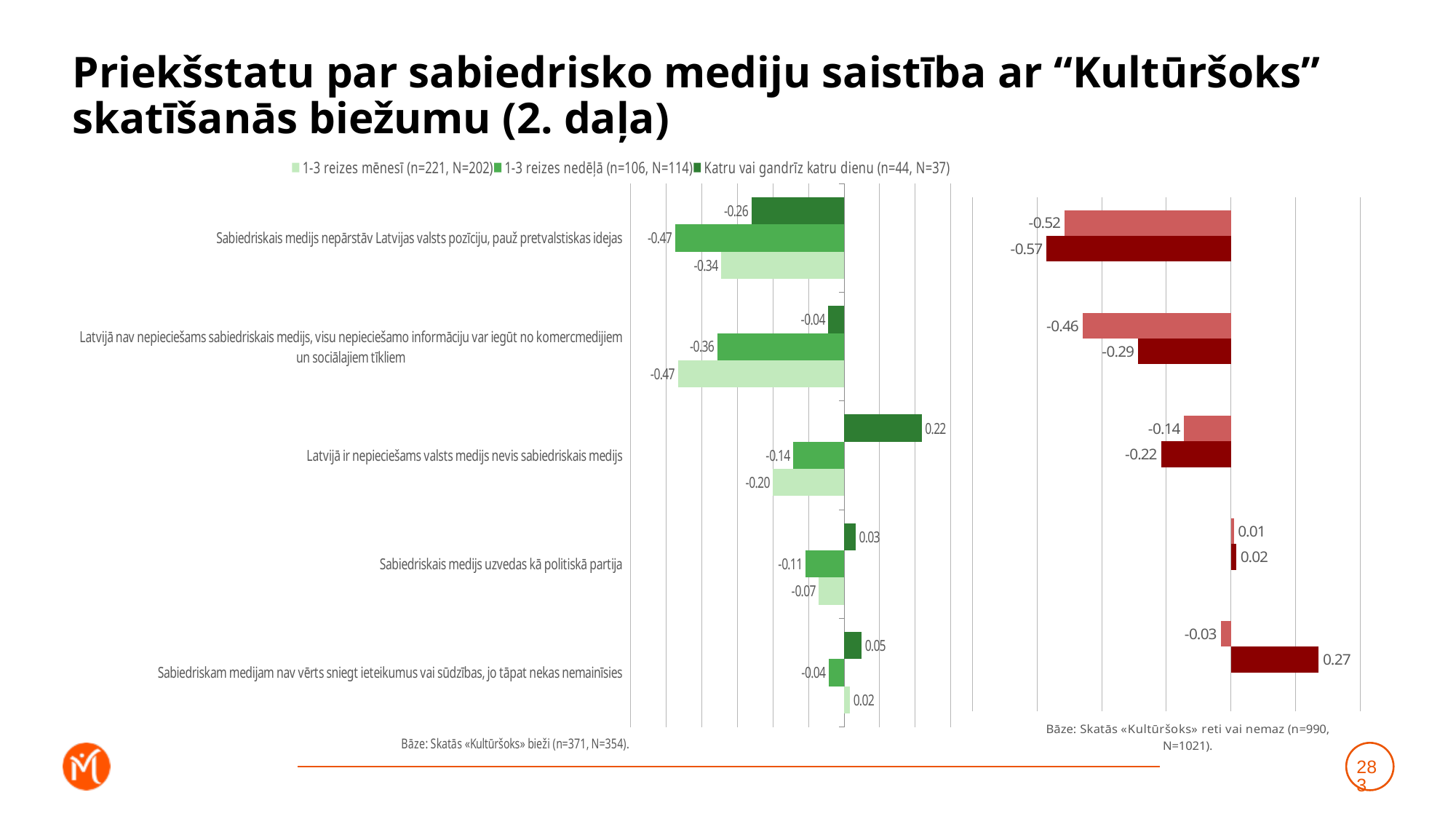
How many statements (categories) are shown on the left (green) chart? 5 On the left (green) chart, what is the value for "1-3 reizes mēnesī" for the statement "Sabiedriskais medijs uzvedas kā politiskā partija"? -0.07 On the left (green) chart, for which statement is the "Katru vai gandrīz katru dienu" value the highest? Latvijā ir nepieciešams valsts medijs nevis sabiedriskais medijs What kind of chart is the left (green) chart? Bar chart On the left (green) chart, what is the value for "1-3 reizes nedēļā" for the statement "Sabiedriskais medijs nepārstāv Latvijas valsts pozīciju, pauž pretvalstiskas idejas"? -0.47 How many series does the legend of the left (green) chart list? 3 On the left (green) chart, what is the difference between the "1-3 reizes nedēļā" value (-0.47) and the "Katru vai gandrīz katru dienu" value (-0.26) for the statement "Sabiedriskais medijs nepārstāv Latvijas valsts pozīciju, pauž pretvalstiskas idejas"? 0.21 On the left (green) chart, for which statement is the "1-3 reizes mēnesī" value the lowest? Latvijā nav nepieciešams sabiedriskais medijs, visu nepieciešamo informāciju var iegūt no komercmedijiem un sociālajiem tīkliem On the right (red) chart, what is the value of the darker red bar for the statement "Sabiedriskam medijam nav vērts sniegt ieteikumus vai sūdzības, jo tāpat nekas nemainīsies"? 0.27 On the left (green) chart, what is the value for "Katru vai gandrīz katru dienu" for the statement "Latvijā ir nepieciešams valsts medijs nevis sabiedriskais medijs"? 0.22 On the left (green) chart, what is the value for "Katru vai gandrīz katru dienu" for the statement "Latvijā nav nepieciešams sabiedriskais medijs, visu nepieciešamo informāciju var iegūt no komercmedijiem un sociālajiem tīkliem"? -0.04 On the left (green) chart, for the statement "Sabiedriskam medijam nav vērts sniegt ieteikumus vai sūdzības, jo tāpat nekas nemainīsies", which is larger: the "Katru vai gandrīz katru dienu" value or the "1-3 reizes mēnesī" value? Katru vai gandrīz katru dienu